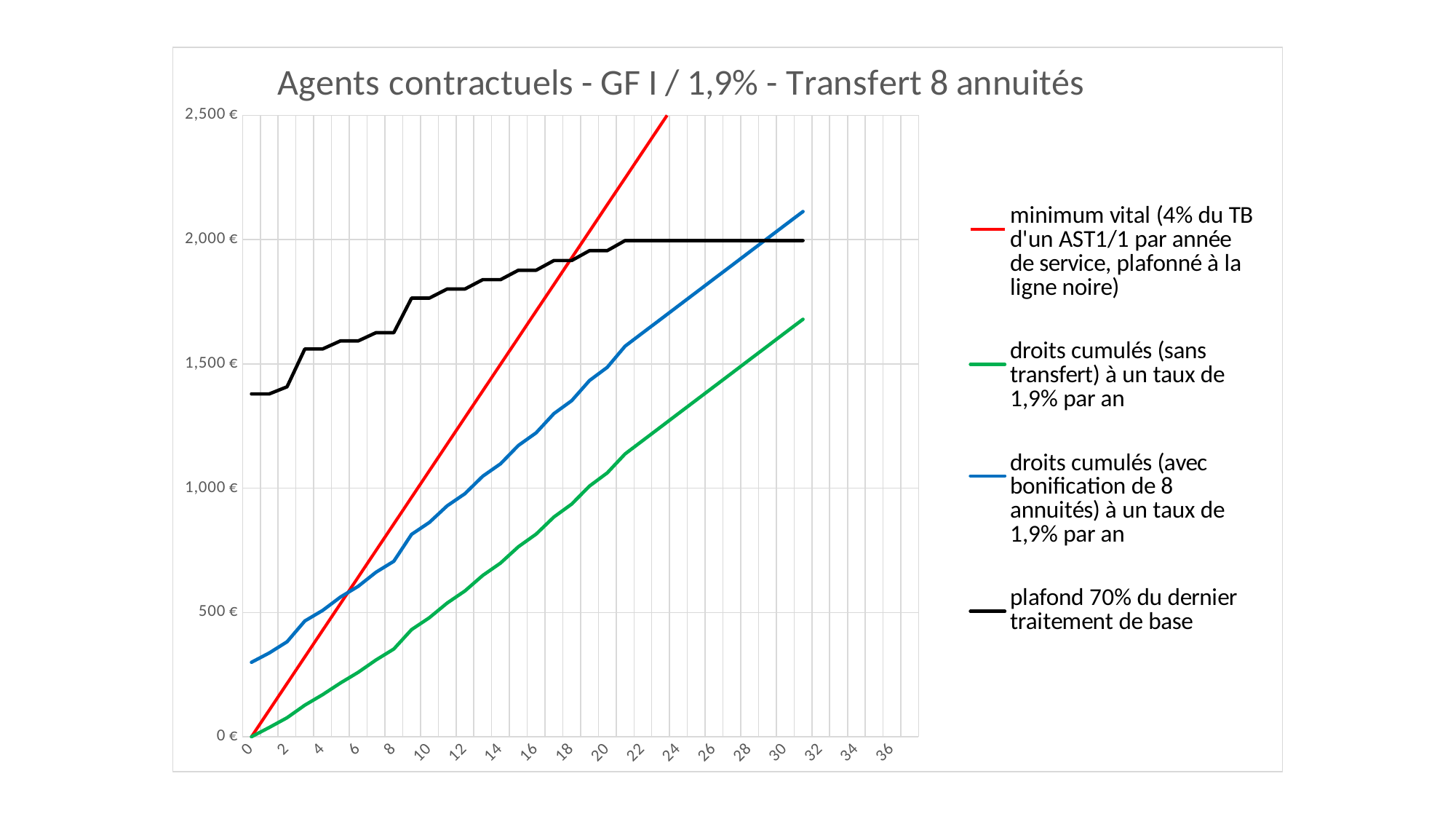
Which colour is used for the series 'plafond 70% du dernier traitement de base'? black Is the value of the black 'plafond 70% du dernier traitement de base' line at x = 0 greater or less than 1,500 €? less Is the value of the blue 'droits cumulés (avec bonification de 8 annuités)' line at x = 24 greater or less than 1,500 €? greater At x = 20, which is larger: the red 'minimum vital' line or the black 'plafond 70%' line? the red line (minimum vital) What is the title of the chart? Agents contractuels - GF I / 1,9% - Transfert 8 annuités At x = 10, which is larger: the blue 'droits cumulés (avec bonification)' line or the green 'droits cumulés (sans transfert)' line? the blue line (avec bonification) Is the value of the green 'droits cumulés (sans transfert)' line at x = 30 greater or less than 1,500 €? greater How many series does the legend list? 4 At x = 10, which of the four series has the highest value? plafond 70% du dernier traitement de base What kind of chart is shown on the slide? line chart Does the series 'droits cumulés (avec bonification de 8 annuités) à un taux de 1,9% par an' rise or fall along the x axis? rise